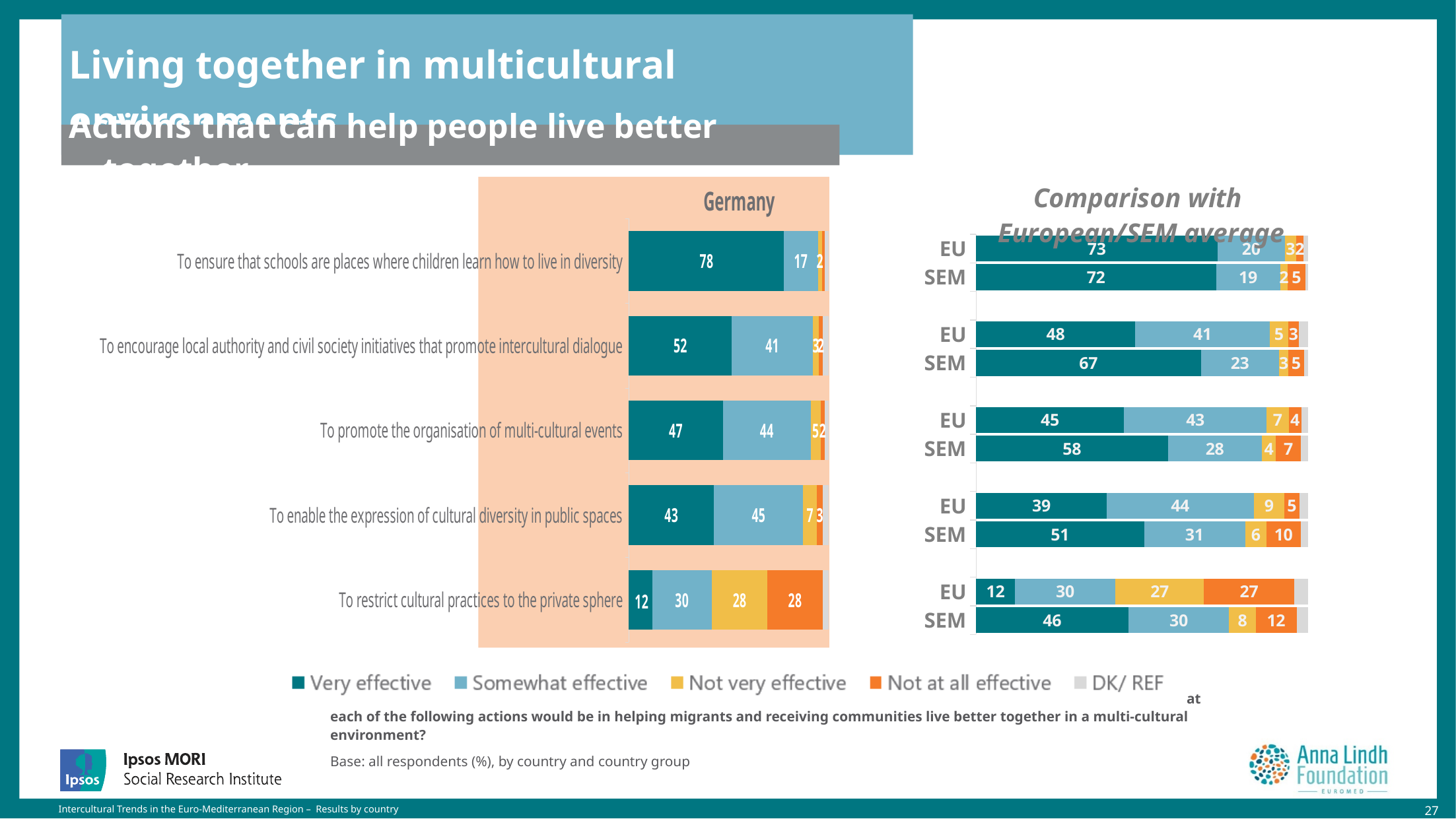
In the Germany chart, what percentage rated 'To restrict cultural practices to the private sphere' as Not at all effective? 28 In the Germany chart, what is the difference between the Very effective values for the schools action (78) and the local authority initiatives action (52)? 26 In the Germany chart, what percentage rated 'To ensure that schools are places where children learn how to live in diversity' as Very effective? 78 What kind of chart is the Germany chart? Bar chart In the Comparison with European/SEM average chart, what is the difference between the SEM (67) and EU (48) Very effective values for encouraging local authority and civil society initiatives? 19 How many series does the legend list? 5 How many actions (categories) are shown in the Germany chart? 5 In the Comparison with European/SEM average chart, what is the EU Not at all effective value for restricting cultural practices to the private sphere? 27 In the Germany chart, which action has the lowest Very effective value? To restrict cultural practices to the private sphere In the Germany chart, which action has the highest Very effective value? To ensure that schools are places where children learn how to live in diversity In the Germany chart, which has the larger Very effective value: encouraging local authority and civil society initiatives, or promoting the organisation of multi-cultural events? To encourage local authority and civil society initiatives that promote intercultural dialogue In the Comparison with European/SEM average chart, what is the SEM Very effective value for restricting cultural practices to the private sphere? 46